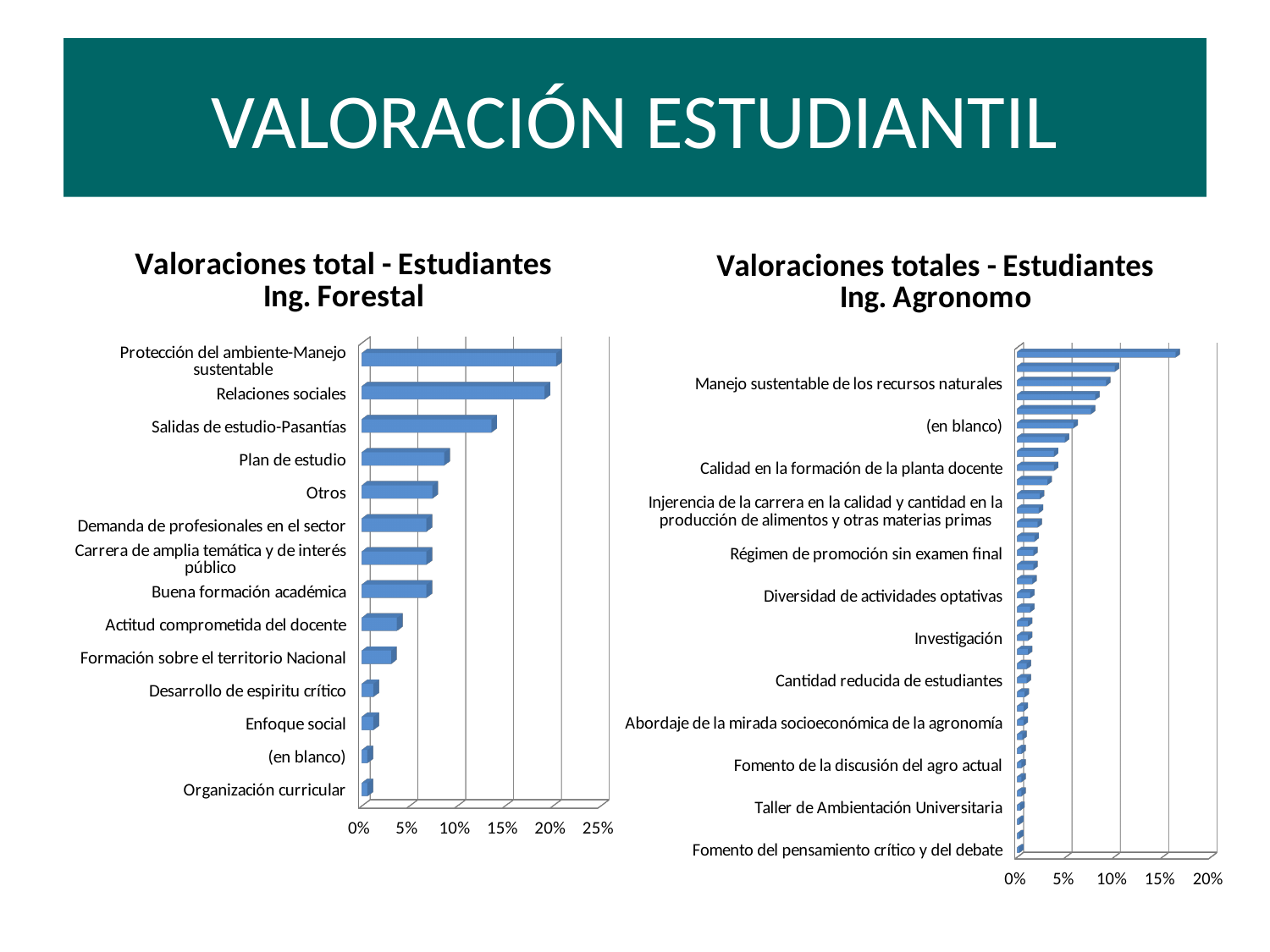
In the 'Valoraciones totales - Estudiantes Ing. Agronomo' chart, do the bar values rise or fall going from the top category to the bottom category? fall What kind of chart is the 'Valoraciones total - Estudiantes Ing. Forestal' chart? Bar chart In the 'Valoraciones total - Estudiantes Ing. Forestal' chart, which category has the highest value? Protección del ambiente-Manejo sustentable In the 'Valoraciones total - Estudiantes Ing. Forestal' chart, is the value for Actitud comprometida del docente greater or less than 5%? less In the 'Valoraciones total - Estudiantes Ing. Forestal' chart, which is larger: Salidas de estudio-Pasantías or Plan de estudio? Salidas de estudio-Pasantías In the 'Valoraciones total - Estudiantes Ing. Forestal' chart, which is larger: Relaciones sociales or Otros? Relaciones sociales What kind of chart is the 'Valoraciones totales - Estudiantes Ing. Agronomo' chart? Bar chart In the 'Valoraciones totales - Estudiantes Ing. Agronomo' chart, is the value for Fomento del pensamiento crítico y del debate greater or less than 5%? less How many categories are shown in the 'Valoraciones total - Estudiantes Ing. Forestal' chart? 14 In the 'Valoraciones total - Estudiantes Ing. Forestal' chart, is the value for Salidas de estudio-Pasantías greater or less than 10%? greater What is the highest value shown on the horizontal axis of the 'Valoraciones total - Estudiantes Ing. Forestal' chart? 25%